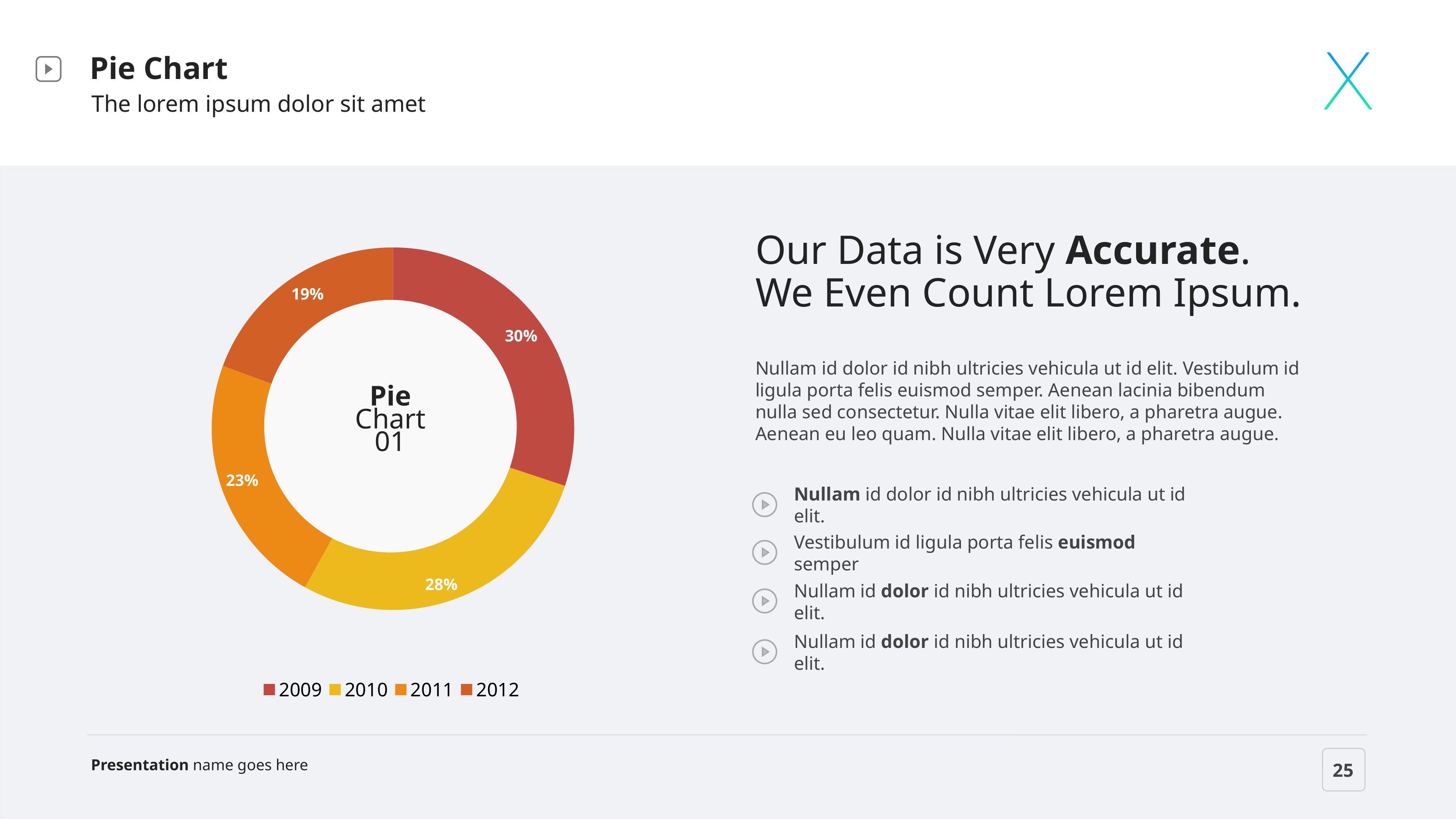
What share of the pie chart does 2011 represent? 23% What kind of chart is shown on the slide? Pie chart How many slices does the pie chart have? 4 What is the difference in percentage points between the 2009 and 2012 slices? 11 Which slice is larger, 2010 or 2011? 2010 What share of the pie chart does 2009 represent? 30% Which year has the smallest slice in the pie chart? 2012 What share of the pie chart does 2012 represent? 19% Which year has the largest slice in the pie chart? 2009 How many entries does the legend list? 4 What share of the pie chart does 2010 represent? 28% What text is shown in the centre of the pie chart? Pie Chart 01